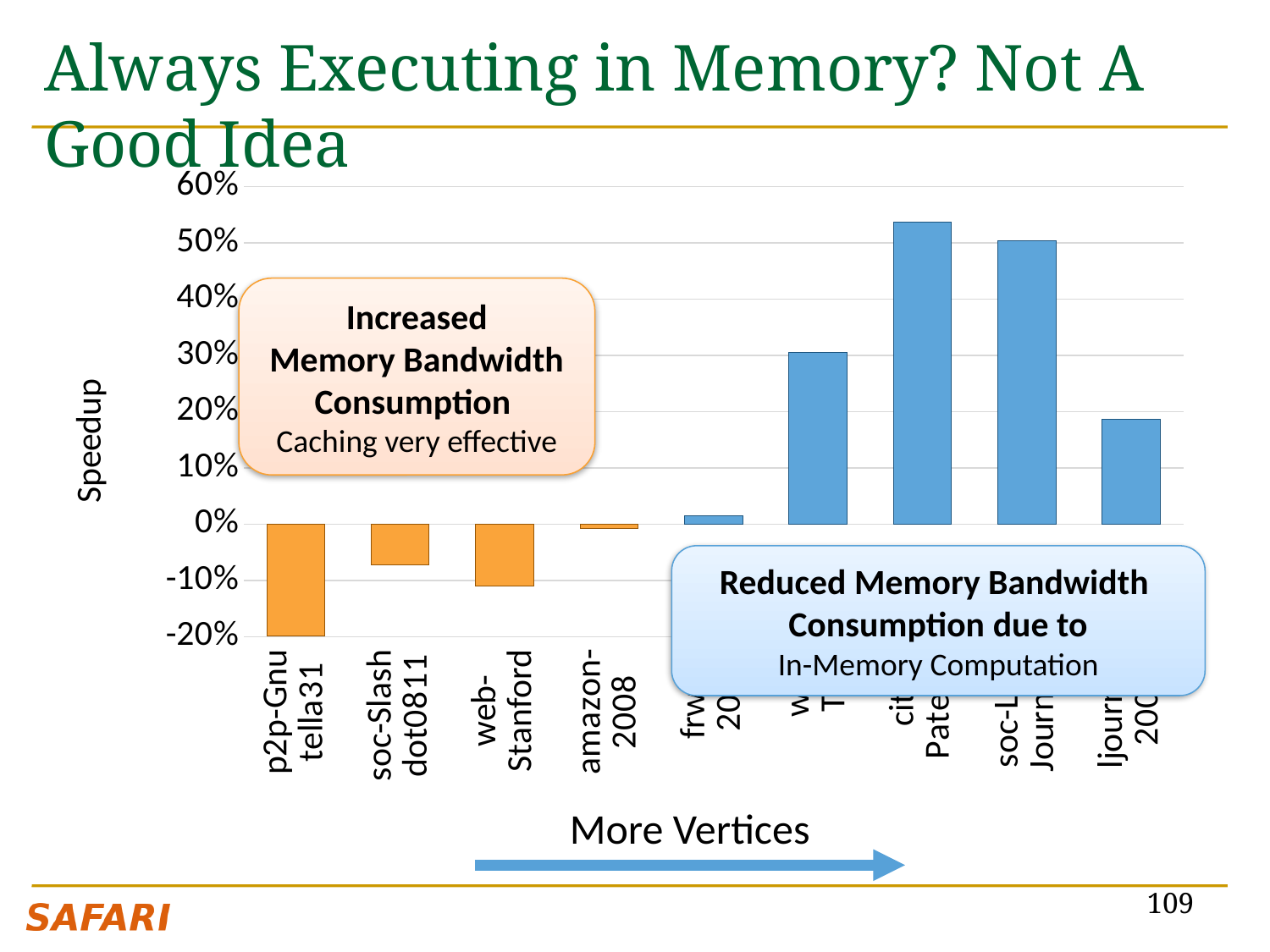
What is the label of the vertical axis of the chart? Speedup Is the speedup for soc-Slashdot0811 greater or less than 0%? less How many bars (categories) are plotted in the chart? 9 Which bar is the tallest in the chart, counting from the left? the seventh bar Is the speedup for the seventh bar from the left greater or less than 50%? greater Which category has the lowest speedup in the chart? p2p-Gnutella31 Is the speedup for the rightmost bar greater or less than 20%? less How many bars in the chart are coloured orange? 4 Which has the higher speedup, p2p-Gnutella31 or soc-Slashdot0811? soc-Slashdot0811 What kind of chart is shown on the slide? bar chart